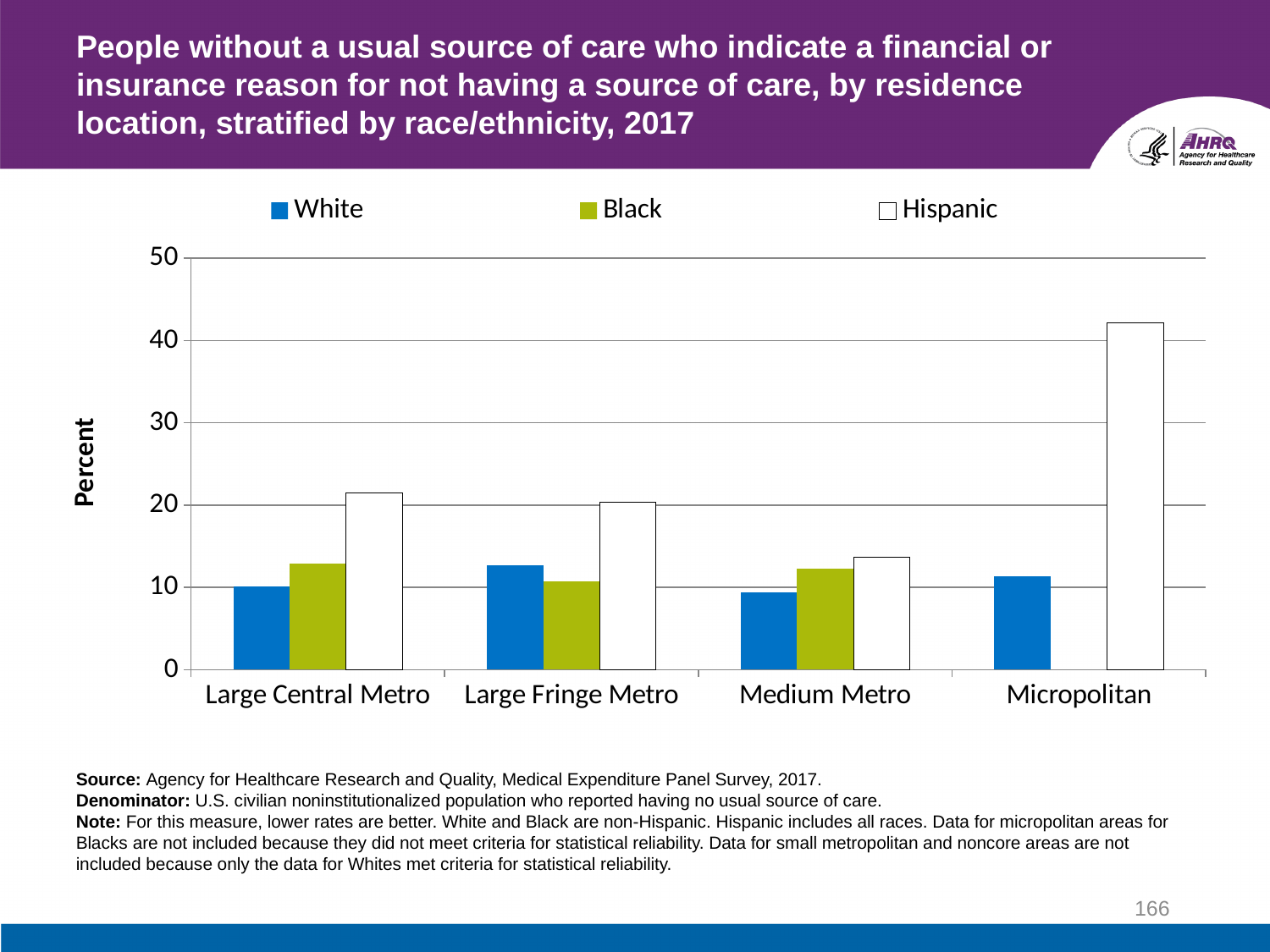
What is the label on the y axis? Percent In Large Central Metro, which is larger, the White value or the Black value? Black Which bar is the highest in the chart? Hispanic, Micropolitan How many residence location categories are shown on the x axis? 4 Among the Hispanic bars, which residence location has the lowest value? Medium Metro Is the value for Hispanic in Medium Metro greater or less than 20? less In Large Fringe Metro, which is larger, the White value or the Black value? White Is the value for Black in Large Central Metro greater or less than 10? greater How many series does the legend list? 3 Is the value for Hispanic in Micropolitan greater or less than 30? greater What kind of chart is shown on the slide? bar chart In Micropolitan, which is larger, the White value or the Hispanic value? Hispanic